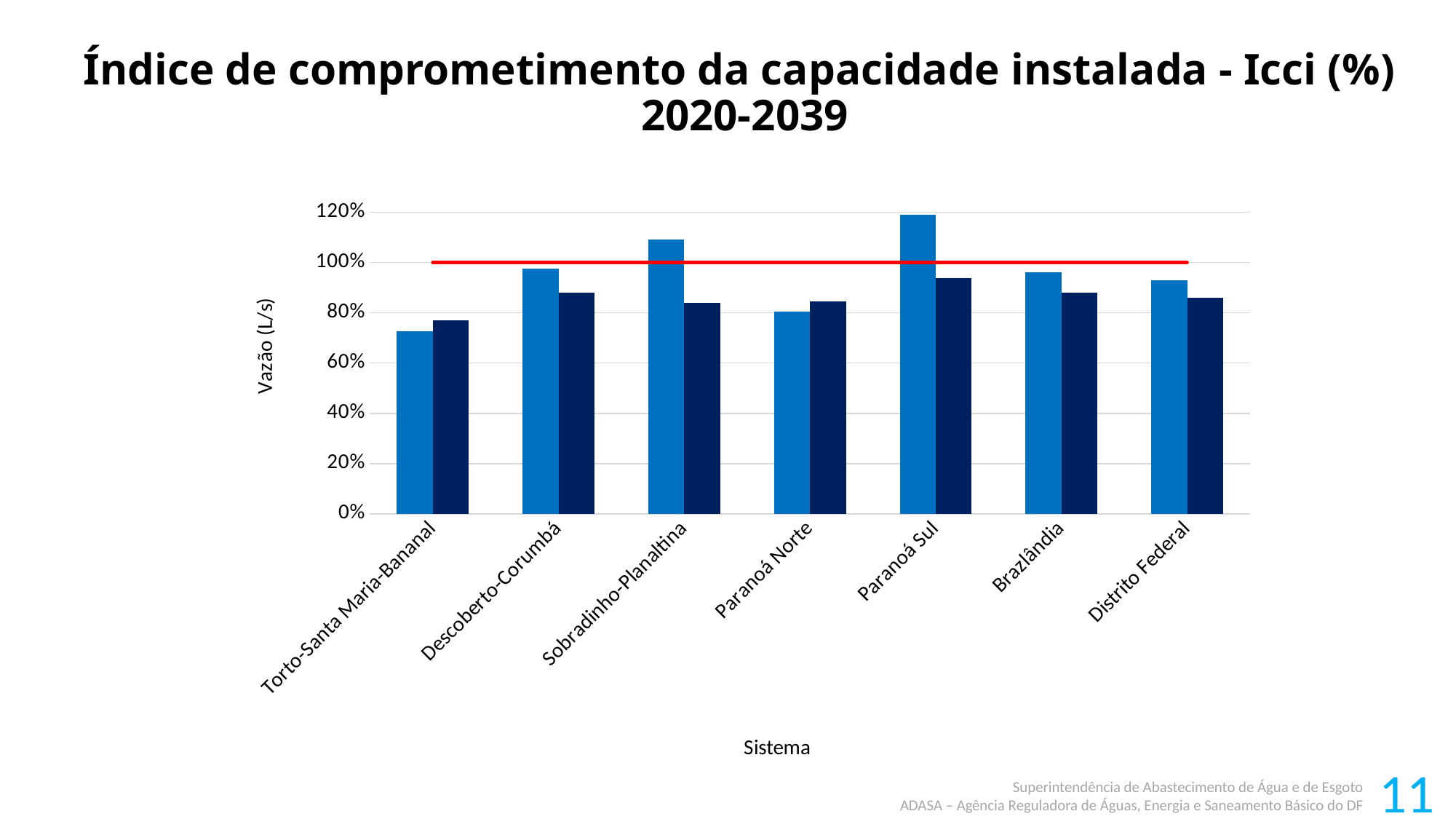
Which system has the tallest light blue bar? Paranoá Sul Is the light blue bar for Torto-Santa Maria-Bananal greater or less than 80%? less Which system has the shortest light blue bar? Torto-Santa Maria-Bananal For Sobradinho-Planaltina, which bar is taller, the light blue or the dark blue? light blue What kind of chart is shown on the slide? bar chart Is the light blue bar for Brazlândia greater or less than 100%? less Which system has the shortest dark blue bar? Torto-Santa Maria-Bananal For Torto-Santa Maria-Bananal, which bar is taller, the light blue or the dark blue? dark blue How many systems (categories) are shown on the x axis? 7 At what value on the y axis is the horizontal red line drawn? 100% Is the light blue bar for Sobradinho-Planaltina greater or less than 100%? greater